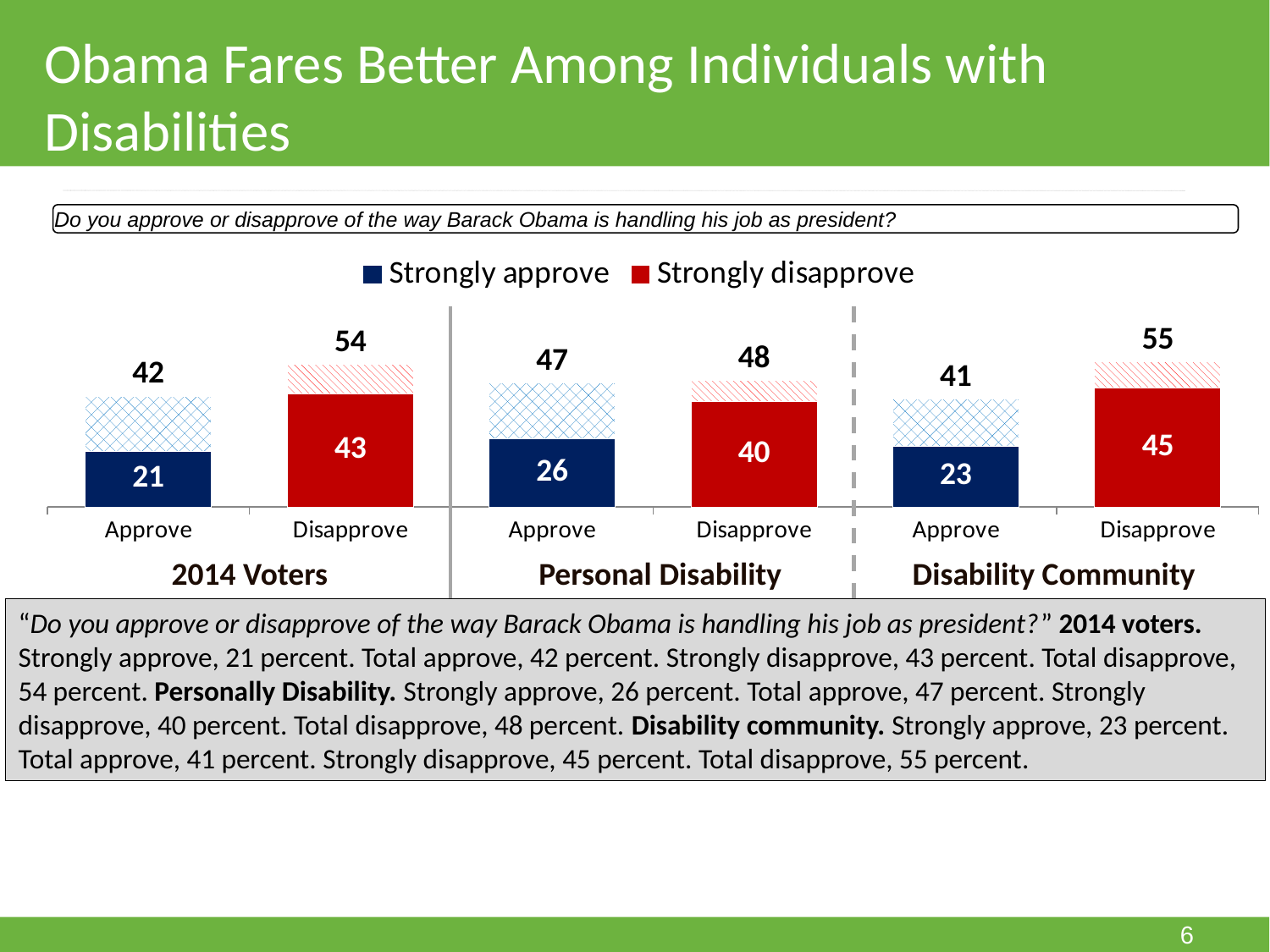
Is the Strongly disapprove value larger for the Disability Community group or the Personal Disability group? Disability Community How many groups of respondents are shown on the chart? 3 What kind of chart is shown on the slide? Bar chart What is the total Approve value for the Personal Disability group? 47 What colour represents Strongly disapprove in the legend? Red What is the Strongly approve value for Approve among 2014 Voters? 21 What is the Strongly disapprove value for the Personal Disability group? 40 Which group has the highest total Approve value? Personal Disability What is the total Disapprove value for the Disability Community group? 55 What is the difference between the total Disapprove and total Approve values for 2014 Voters? 12 Which group has the lowest Strongly approve value? 2014 Voters How many series does the legend list? 2